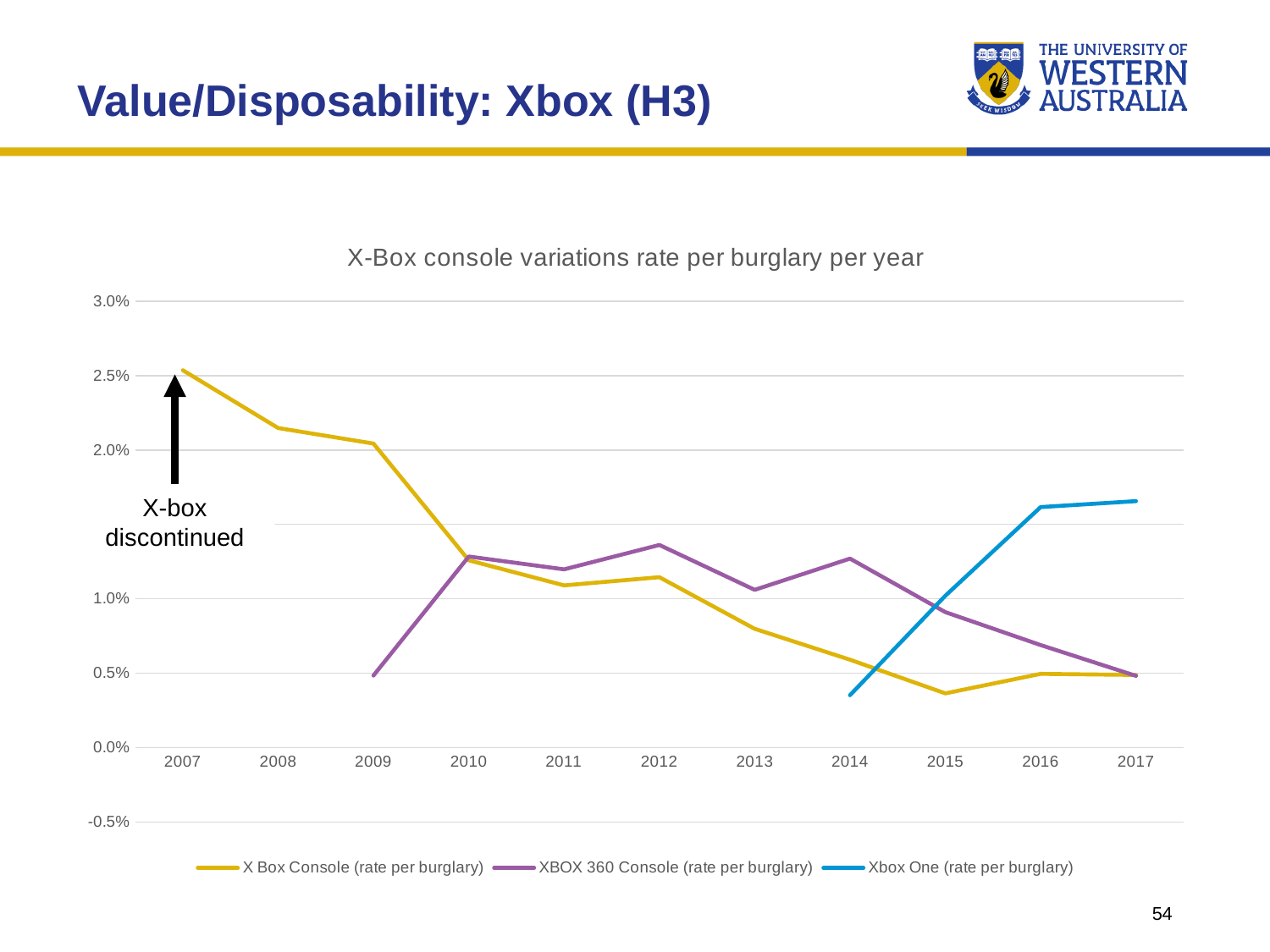
What is the title of the chart? X-Box console variations rate per burglary per year Is the value for X Box Console (rate per burglary) in 2013 greater or less than 1.0%? less Is the value for X Box Console (rate per burglary) in 2008 greater or less than 2.0%? greater How many series does the legend list? 3 How many years are shown on the x axis? 11 In which year is the X Box Console (rate per burglary) line at its highest? 2007 Is the value for Xbox One (rate per burglary) in 2014 greater or less than 0.5%? less Does the Xbox One (rate per burglary) line rise or fall from 2014 to 2017? rise What kind of chart is shown on the slide? line chart In which year is the X Box Console (rate per burglary) line at its lowest? 2015 In 2016, which is larger: Xbox One (rate per burglary) or XBOX 360 Console (rate per burglary)? Xbox One (rate per burglary)